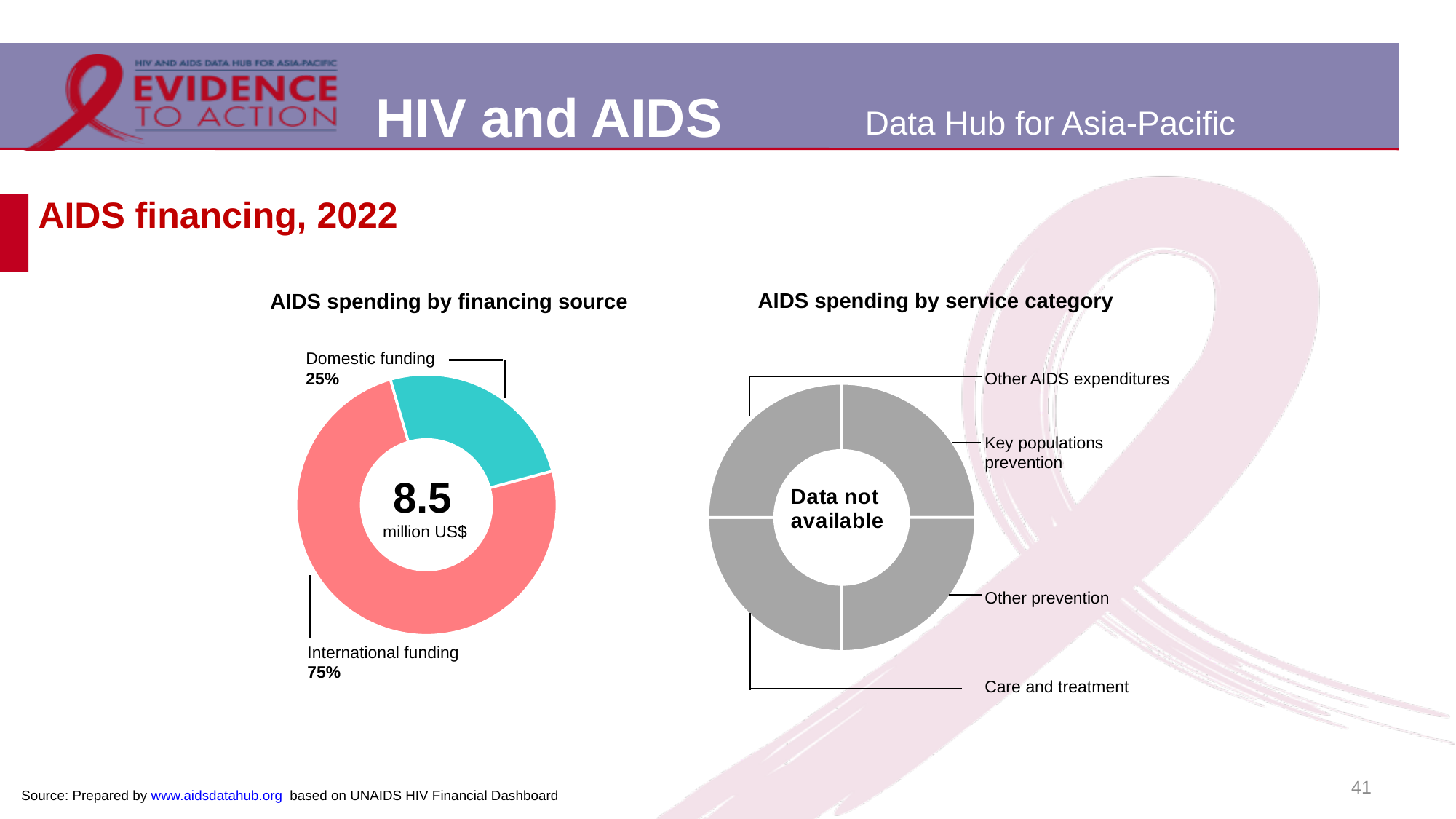
In the 'AIDS spending by financing source' chart, which financing source has the largest share? International funding What does the centre of the 'AIDS spending by service category' chart say? Data not available In the 'AIDS spending by financing source' chart, what colour represents international funding? Red (pink) In the 'AIDS spending by financing source' chart, what total amount is shown in the centre of the donut? 8.5 million US$ In the 'AIDS spending by financing source' chart, what share of spending comes from domestic funding? 25% In the 'AIDS spending by financing source' chart, which financing source has the smallest share? Domestic funding In the 'AIDS spending by financing source' chart, what share of spending comes from international funding? 75% In the 'AIDS spending by financing source' chart, which is larger: domestic funding or international funding? International funding How many service categories are labelled in the 'AIDS spending by service category' chart? 4 What type of chart is used for 'AIDS spending by financing source'? Donut (pie) chart How many financing sources are shown in the 'AIDS spending by financing source' chart? 2 In the 'AIDS spending by financing source' chart, what is the difference in percentage points between international funding and domestic funding? 50 percentage points